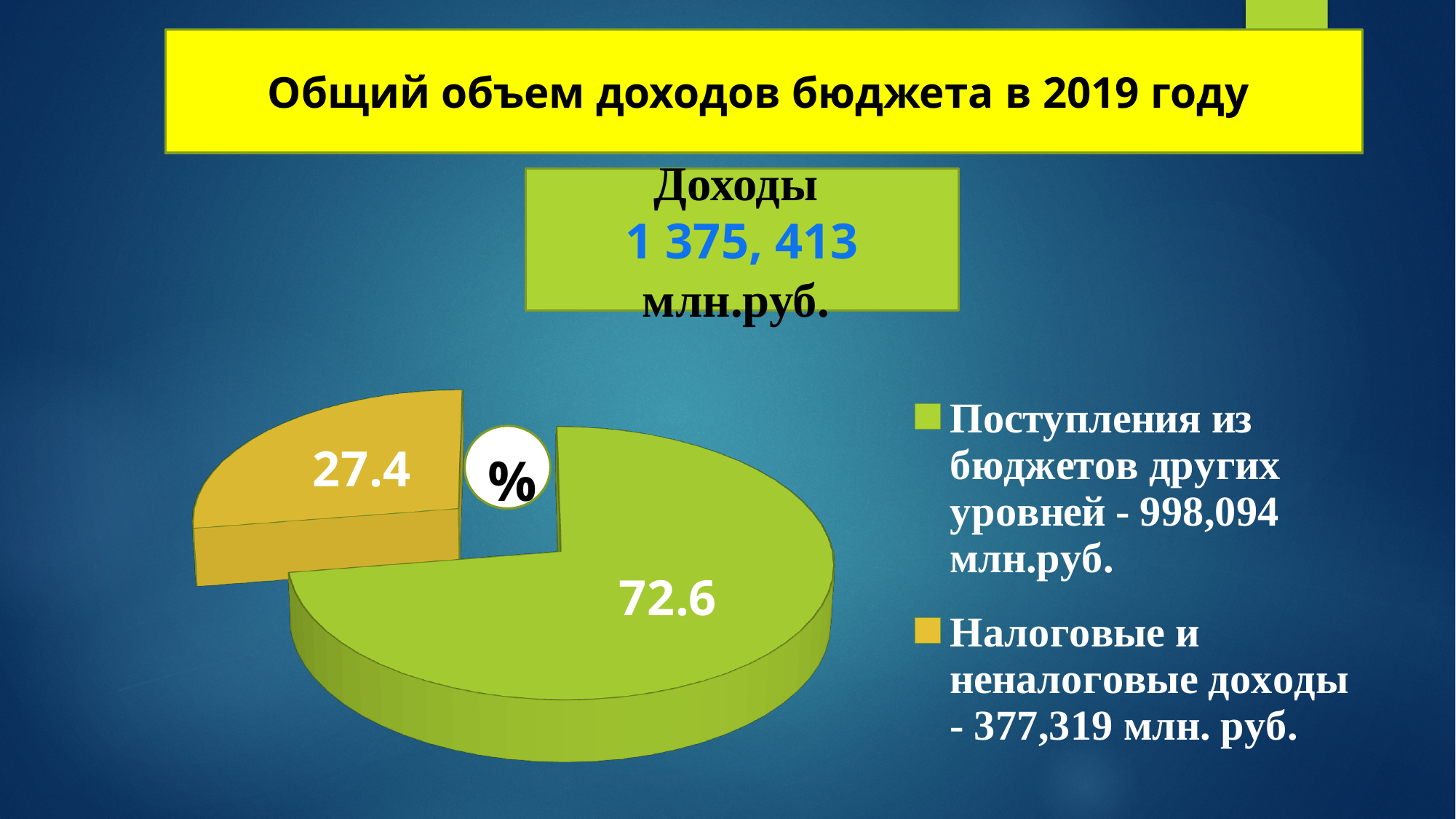
Which category has the largest slice of the pie? Поступления из бюджетов других уровней What percentage share does the slice for "Налоговые и неналоговые доходы" have? 27.4 What percentage share does the slice for "Поступления из бюджетов других уровней" have? 72.6 According to the legend, what amount in млн.руб. corresponds to "Налоговые и неналоговые доходы"? 377,319 млн. руб. How many slices does the pie chart have? 2 What colour is the slice for "Налоговые и неналоговые доходы"? orange Which is larger: the share for "Поступления из бюджетов других уровней" or the share for "Налоговые и неналоговые доходы"? Поступления из бюджетов других уровней What kind of chart is shown on the slide? pie chart How many entries does the legend list? 2 What is the difference in percentage points between the two slices of the pie? 45.2 According to the legend, what amount in млн.руб. corresponds to "Поступления из бюджетов других уровней"? 998,094 млн.руб. Which category has the smallest slice of the pie? Налоговые и неналоговые доходы